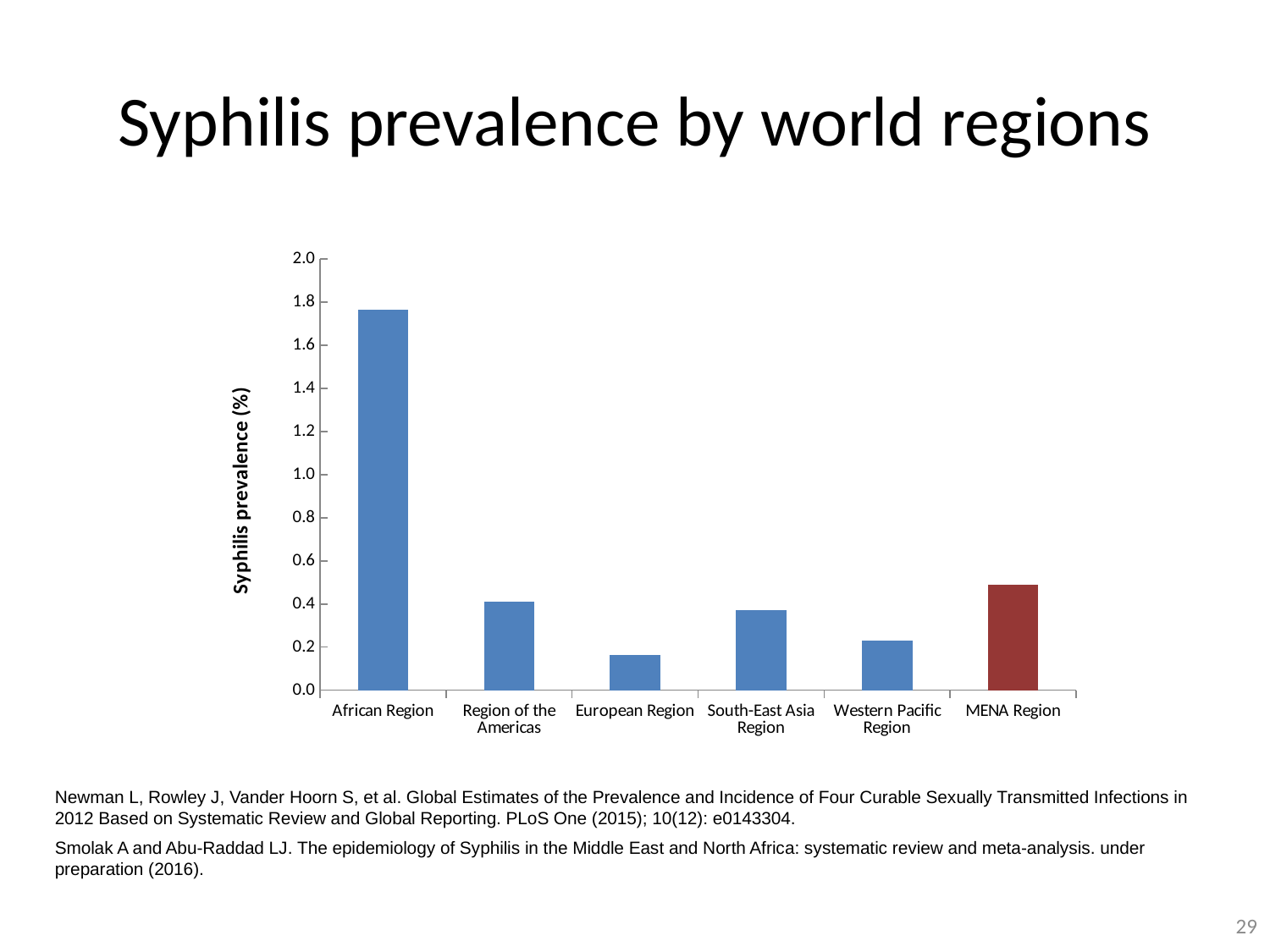
Is the syphilis prevalence for the South-East Asia Region greater or less than 0.2? greater How many regions are plotted in the chart? 6 Is the syphilis prevalence for the European Region greater or less than 0.2? less Is the syphilis prevalence for the African Region greater or less than 1.6? greater What kind of chart is shown on the slide? bar chart Which has a higher syphilis prevalence, the Region of the Americas or the European Region? Region of the Americas Which region has the highest syphilis prevalence? African Region What is the label of the vertical axis? Syphilis prevalence (%) Which has a higher syphilis prevalence, the MENA Region or the Western Pacific Region? MENA Region Which region has the lowest syphilis prevalence? European Region Which region's bar is coloured red rather than blue? MENA Region